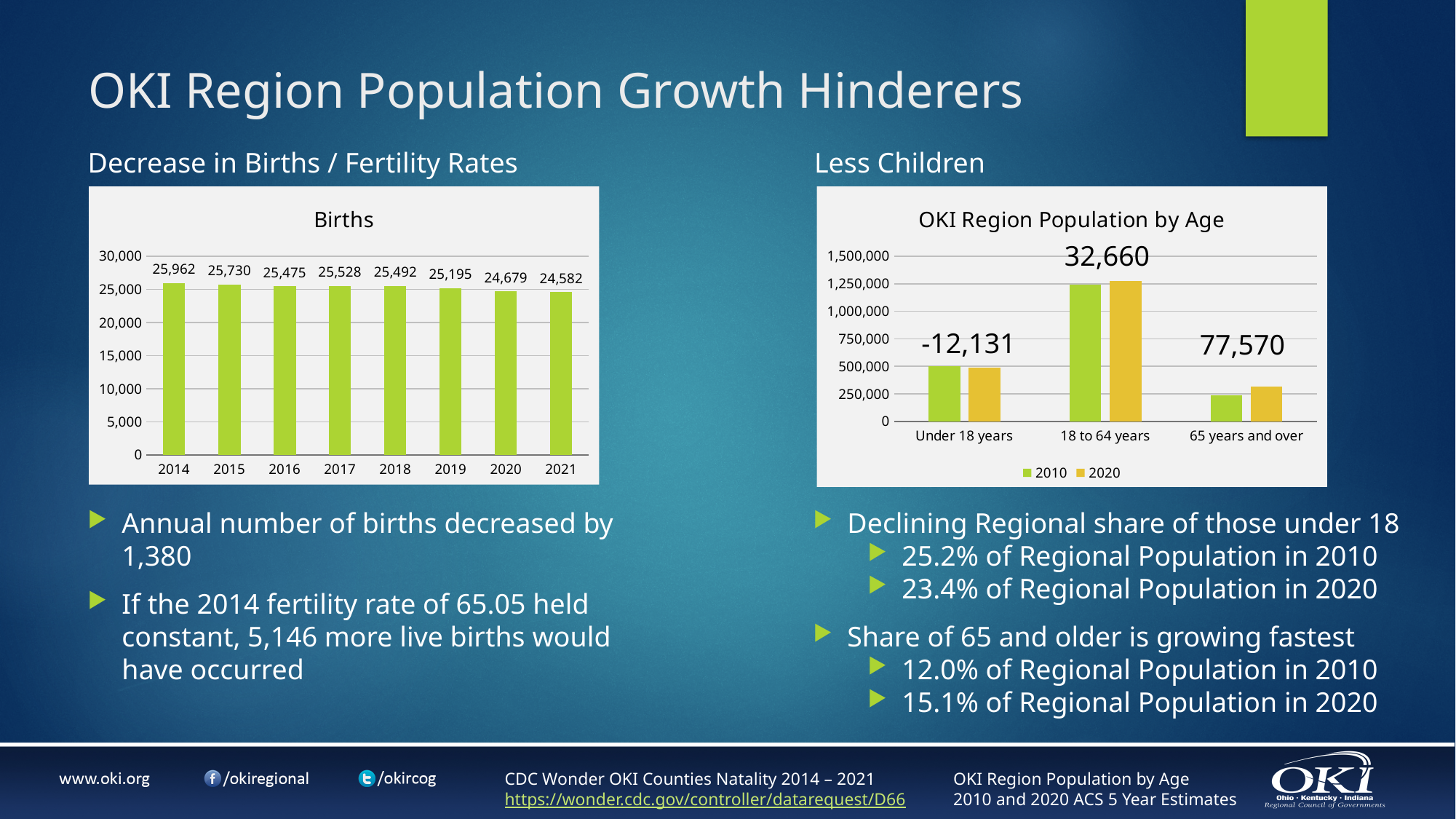
In the Births chart, what was the number of births in 2021? 24,582 In the Births chart, what was the number of births in 2018? 25,492 In the Births chart, which year had the highest number of births? 2014 What kind of chart is the OKI Region Population by Age chart? bar chart In the Births chart, do births generally rise or fall from 2014 to 2021? fall In the Births chart, what is the difference between births in 2014 and births in 2021? 1,380 In the Births chart, which year had more births, 2016 or 2017? 2017 In the Births chart, what was the number of births in 2014? 25,962 In the Births chart, which year had the lowest number of births? 2021 How many years are shown in the Births chart? 8 How many series does the legend of the OKI Region Population by Age chart list? 2